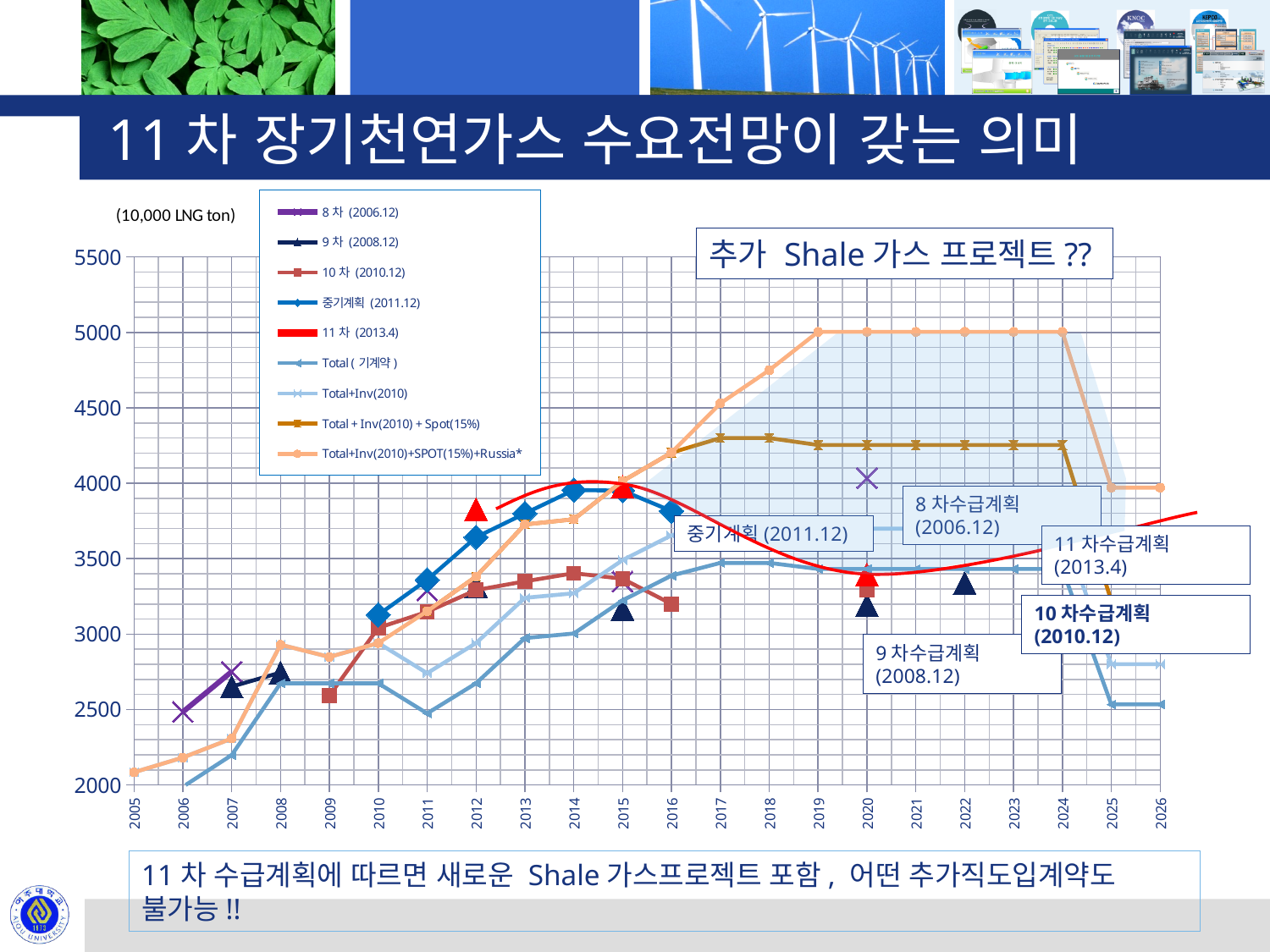
What kind of chart is shown on the slide? line chart How many years are shown along the x axis of the chart? 22 Is the value of the 9 차 (2008.12) series in 2022 greater or less than 3000? greater What unit label is shown above the y axis of the chart? (10,000 LNG ton) Is the value of the 10 차 (2010.12) series in 2016 greater or less than 3000? greater In 2020, which is larger: the Total+Inv(2010)+SPOT(15%)+Russia* series or the Total + Inv(2010) + Spot(15%) series? Total+Inv(2010)+SPOT(15%)+Russia* Which series reaches the highest value on the chart? Total+Inv(2010)+SPOT(15%)+Russia* Is the value of the Total ( 기계약 ) series in 2026 greater or less than 3000? less Does the Total+Inv(2010)+SPOT(15%)+Russia* series rise or fall from 2005 to 2019? rise How many series does the chart legend list? 9